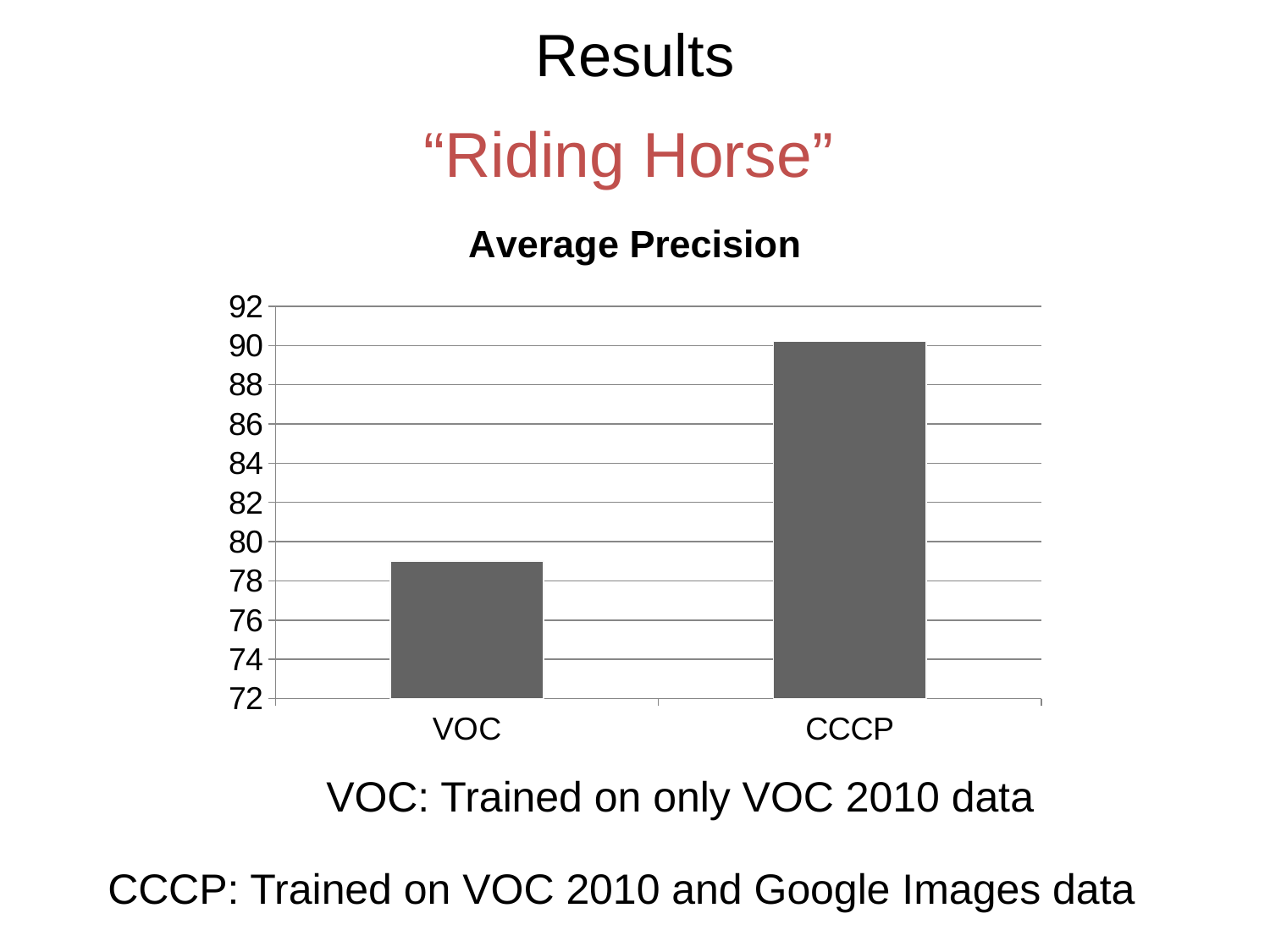
What is the title of the chart? Average Precision Do the values rise or fall from VOC to CCCP along the x axis? rise Which category has the lowest average precision? VOC Which is larger, the value for VOC or the value for CCCP? CCCP Is the value for CCCP greater or less than 92? less What kind of chart is shown on the slide? bar chart Is the value for CCCP greater or less than 88? greater Is the value for VOC greater or less than 76? greater How many categories are plotted in the chart? 2 Which category has the highest average precision? CCCP What is the lowest value shown on the vertical axis? 72